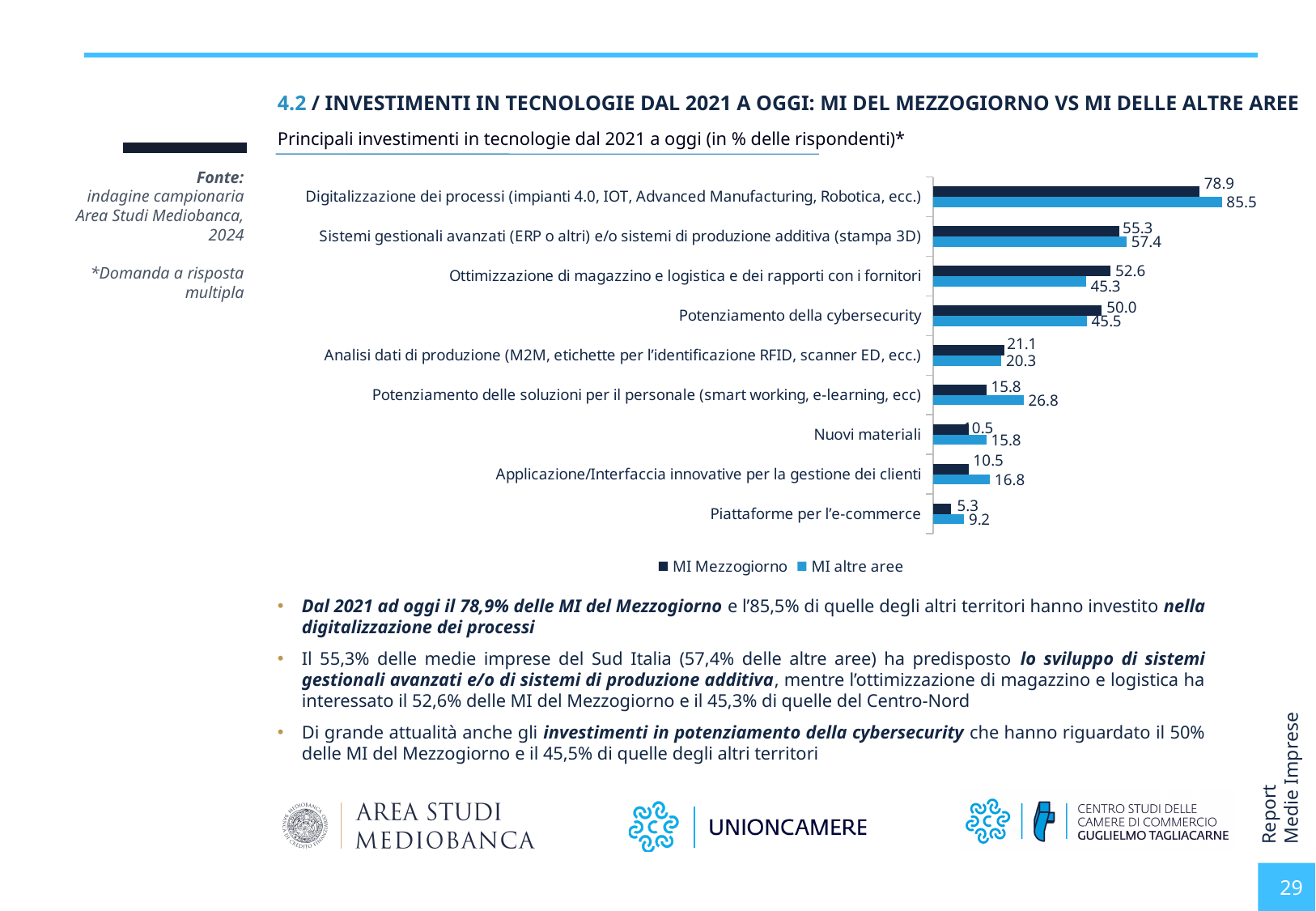
How many series does the legend list? 2 Which category has the highest value for MI altre aree? Digitalizzazione dei processi (impianti 4.0, IOT, Advanced Manufacturing, Robotica, ecc.) What is the difference between MI altre aree and MI Mezzogiorno for 'Digitalizzazione dei processi'? 6.6 What is the difference between MI altre aree and MI Mezzogiorno for 'Potenziamento delle soluzioni per il personale'? 11.0 What is the value for MI Mezzogiorno for 'Digitalizzazione dei processi'? 78.9 For 'Ottimizzazione di magazzino e logistica e dei rapporti con i fornitori', which series has the larger value, MI Mezzogiorno or MI altre aree? MI Mezzogiorno What is the value for MI altre aree for 'Piattaforme per l'e-commerce'? 9.2 Which series is shown in dark navy in the legend? MI Mezzogiorno Which category has the lowest value for MI altre aree? Piattaforme per l'e-commerce What is the value for MI altre aree for 'Potenziamento della cybersecurity'? 45.5 What kind of chart is shown on the slide? bar chart How many categories are plotted in the chart? 9